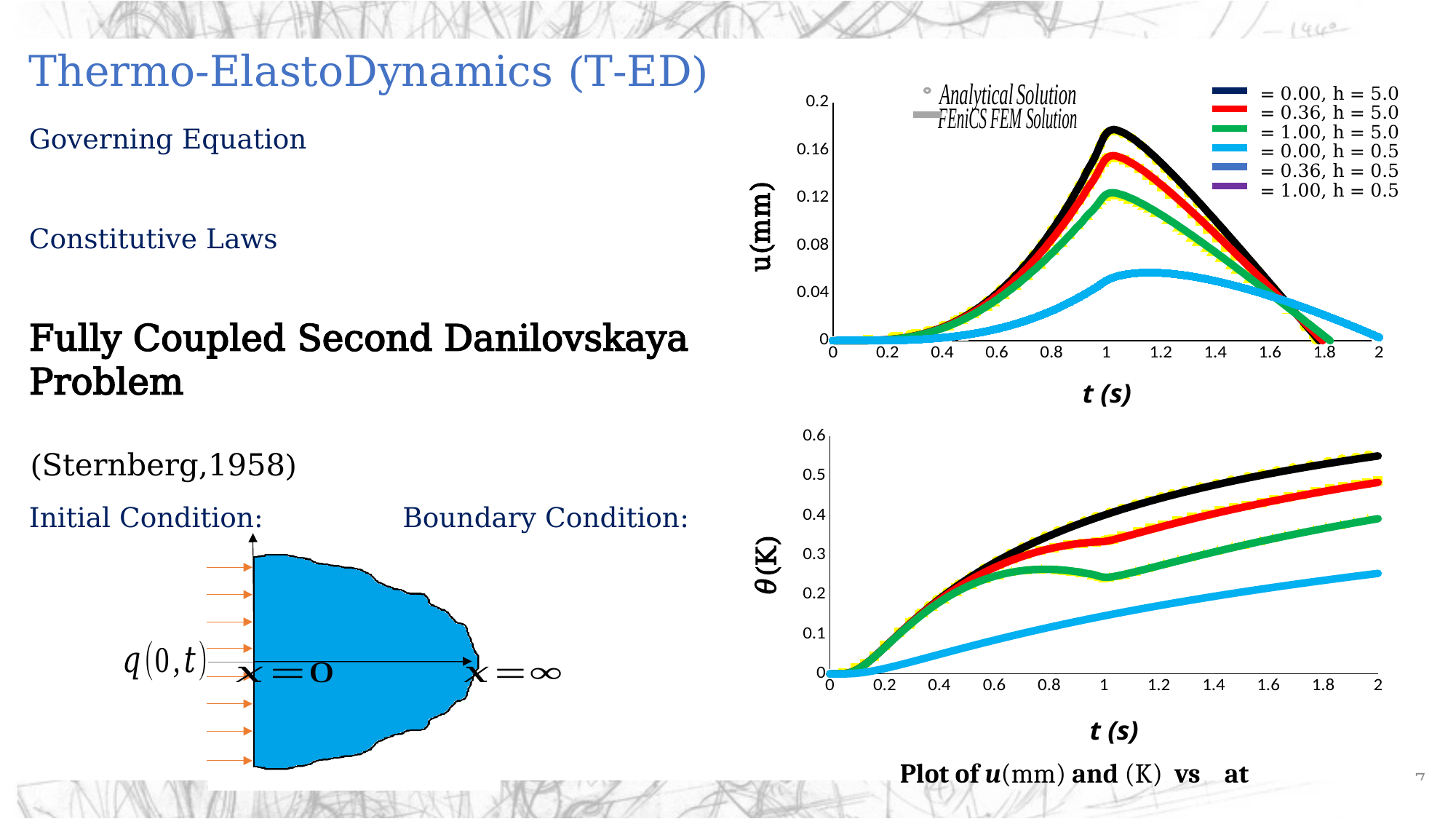
In the bottom chart (θ(K) vs t (s)), is the value of the "= 0.00, h = 0.5" (light blue) line at t = 2 greater or less than 0.3? less In the bottom chart (θ(K) vs t (s)), does the "= 0.00, h = 5.0" line rise or fall as t increases from 0 to 2? rise What kind of chart is the top chart on the slide (u(mm) vs t (s))? line chart In the top chart (u(mm) vs t (s)), is the peak value of the "= 0.00, h = 5.0" line greater or less than 0.16? greater What is the y-axis label of the bottom chart? θ(K) In the top chart (u(mm) vs t (s)), which legend series reaches the highest peak? = 0.00, h = 5.0 In the top chart (u(mm) vs t (s)), does the "= 0.00, h = 5.0" line rise and then fall, or rise throughout, as t increases from 0 to 2? rise and then fall In the bottom chart (θ(K) vs t (s)), at t = 2, which is larger: the "= 0.36, h = 5.0" line or the "= 1.00, h = 5.0" line? = 0.36, h = 5.0 In the bottom chart (θ(K) vs t (s)), is the value of the "= 0.00, h = 5.0" line at t = 2 greater or less than 0.5? greater In the top chart (u(mm) vs t (s)), at t = 1, which is larger: the "= 0.00, h = 5.0" line or the "= 0.00, h = 0.5" line? = 0.00, h = 5.0 How many series does the legend of the top chart list (excluding the Analytical/FEniCS marker key)? 6